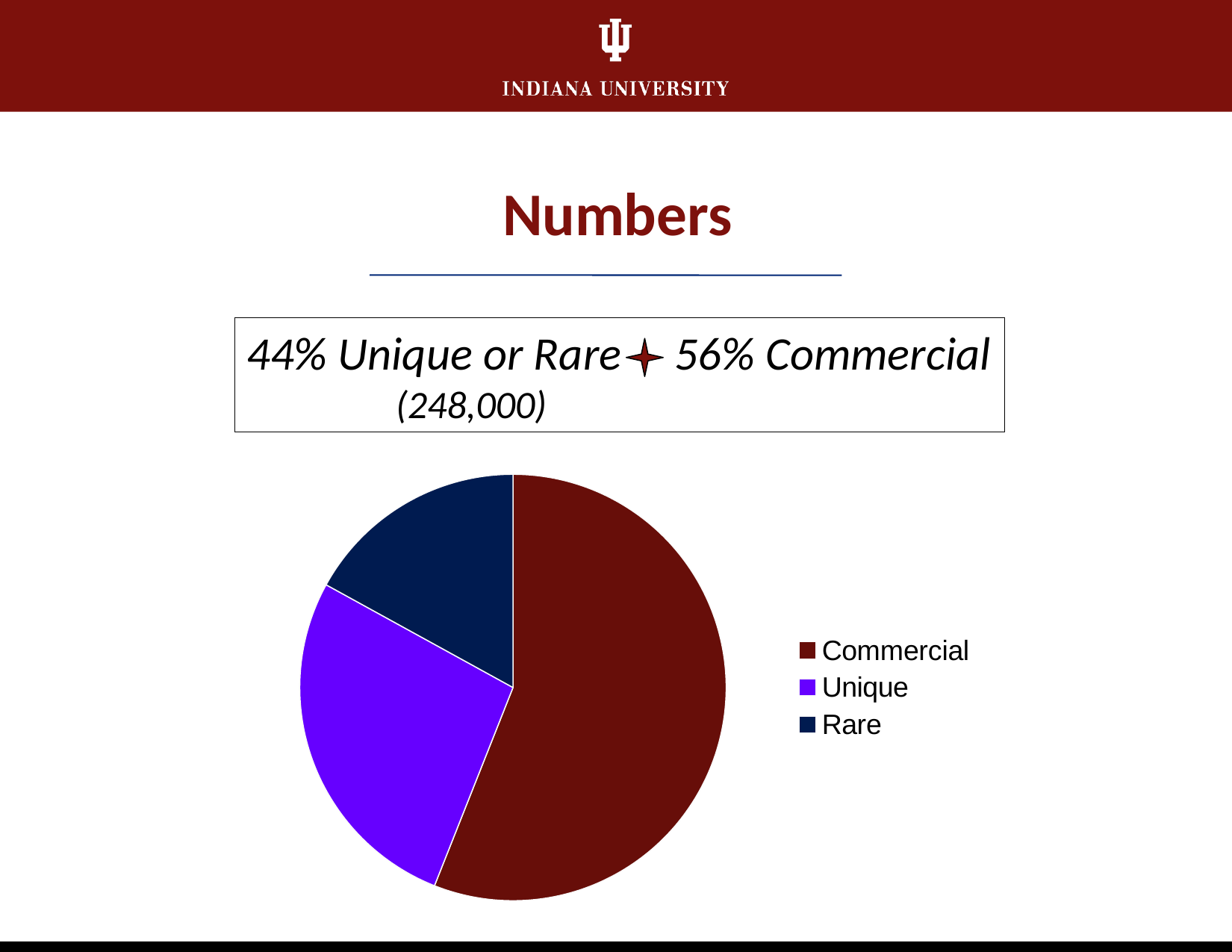
What kind of chart is shown on the slide? pie chart What colour is the Unique slice in the pie chart? purple What share of the pie does Commercial represent? 56% Which slice is larger, Unique or Rare? Unique Which category has the largest slice of the pie chart? Commercial How many slices does the pie chart have? 3 How many entries does the legend of the pie chart list? 3 What total number is given in parentheses on the slide? 248,000 Which slice is larger, Commercial or Unique? Commercial Which category has the smallest slice of the pie chart? Rare What is the title of the slide containing the pie chart? Numbers What combined share of the pie do Unique and Rare represent? 44%